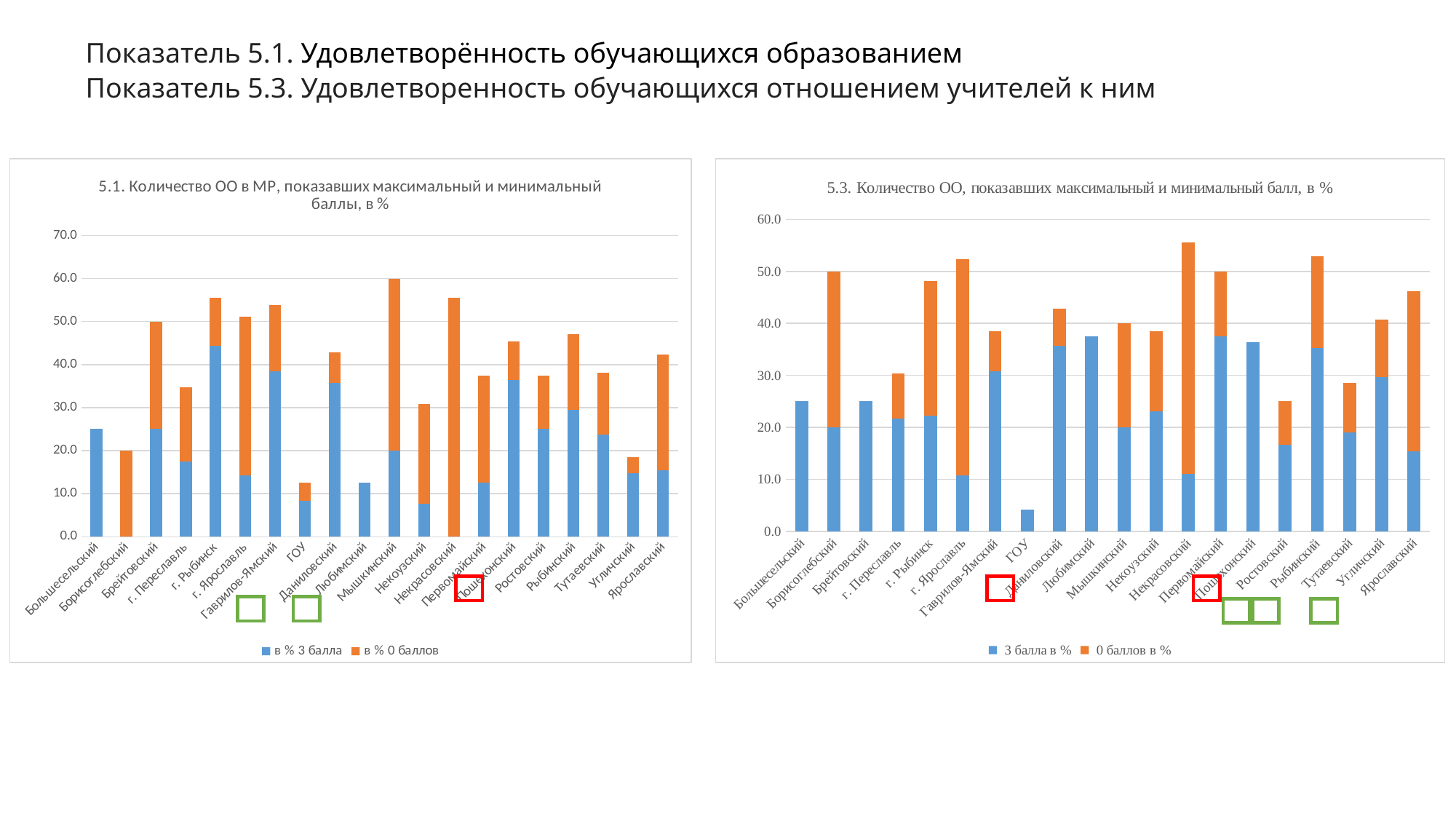
In the right chart (5.3), which category has the tallest stacked bar? Некрасовский In the right chart (5.3), which has the taller stacked bar: Борисоглебский or Тутаевский? Борисоглебский In the left chart (5.1), which has the taller stacked bar: г. Рыбинск or Ростовский? г. Рыбинск In the right chart (5.3), is the total value for ГОУ greater or less than 10? less What kind of chart is the left chart titled "5.1. Количество ОО в МР, показавших максимальный и минимальный баллы, в %"? Stacked bar chart In the right chart (5.3), is the total value for Некрасовский greater or less than 50? greater How many categories are shown on the x axis of the right chart (5.3)? 20 What are the two legend entries of the right chart (5.3)? 3 балла в %; 0 баллов в % How many series does the legend of the left chart (5.1) list? 2 In the left chart (5.1), which category has the tallest stacked bar? Мышкинский In the right chart (5.3), which category has the shortest bar? ГОУ In the left chart (5.1), is the value for Большесельский greater or less than 20? greater